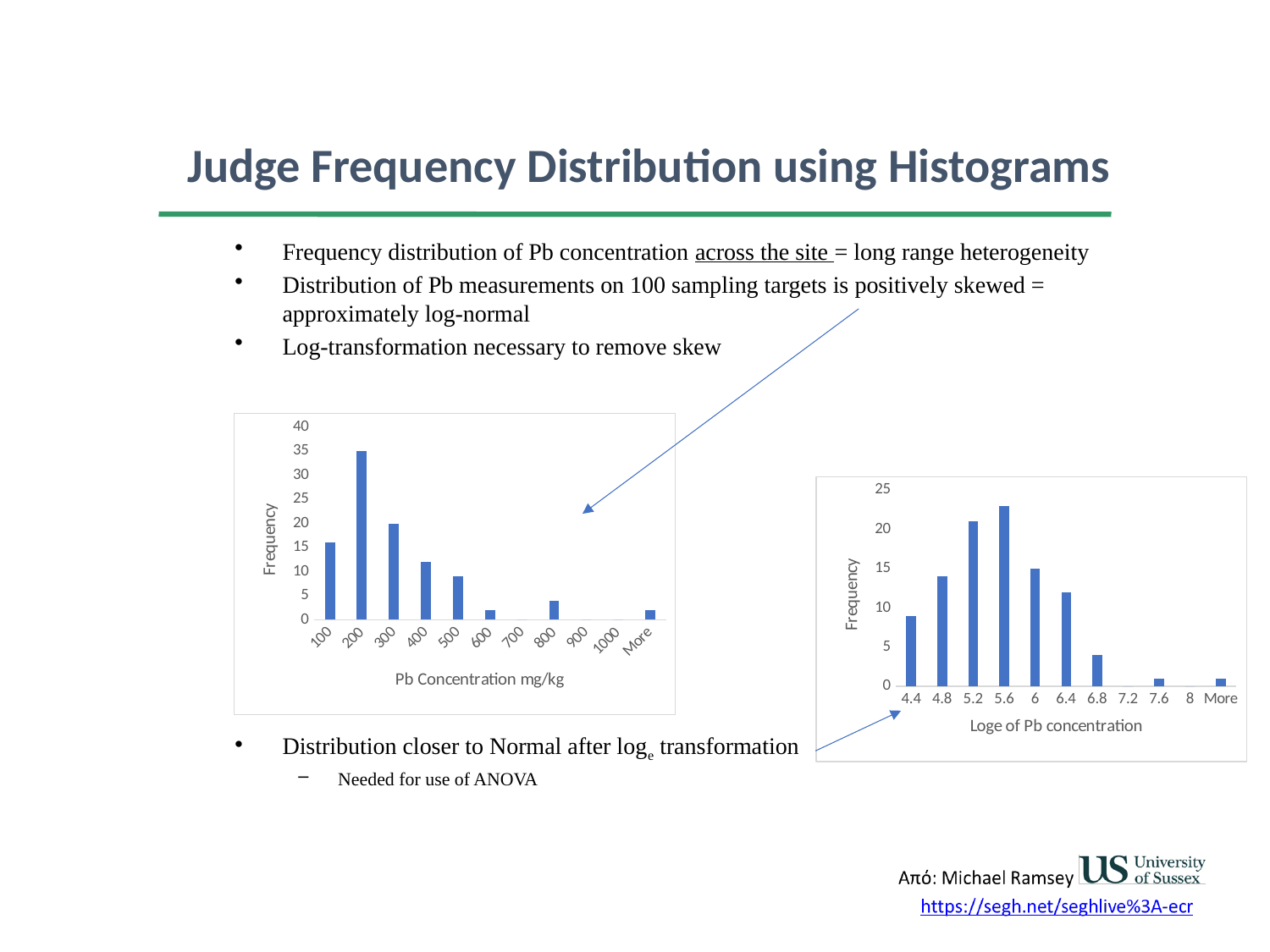
What kind of chart is the chart titled 'Pb Concentration mg/kg'? bar chart In the chart titled 'Loge of Pb concentration', is the frequency for 5.6 greater or less than 20? greater In the chart titled 'Pb Concentration mg/kg', which has the higher frequency, 100 or 400? 100 In the chart titled 'Pb Concentration mg/kg', which category has the highest frequency? 200 How many categories are shown on the x axis of the chart titled 'Loge of Pb concentration'? 11 In the chart titled 'Loge of Pb concentration', which category has the highest frequency? 5.6 In the chart titled 'Pb Concentration mg/kg', is the frequency for 200 greater or less than 30? greater What is the y-axis label of the chart titled 'Pb Concentration mg/kg'? Frequency In the chart titled 'Loge of Pb concentration', is the frequency for 6.8 greater or less than 5? less In the chart titled 'Loge of Pb concentration', which has the higher frequency, 5.2 or 6? 5.2 How many categories are shown on the x axis of the chart titled 'Pb Concentration mg/kg'? 11